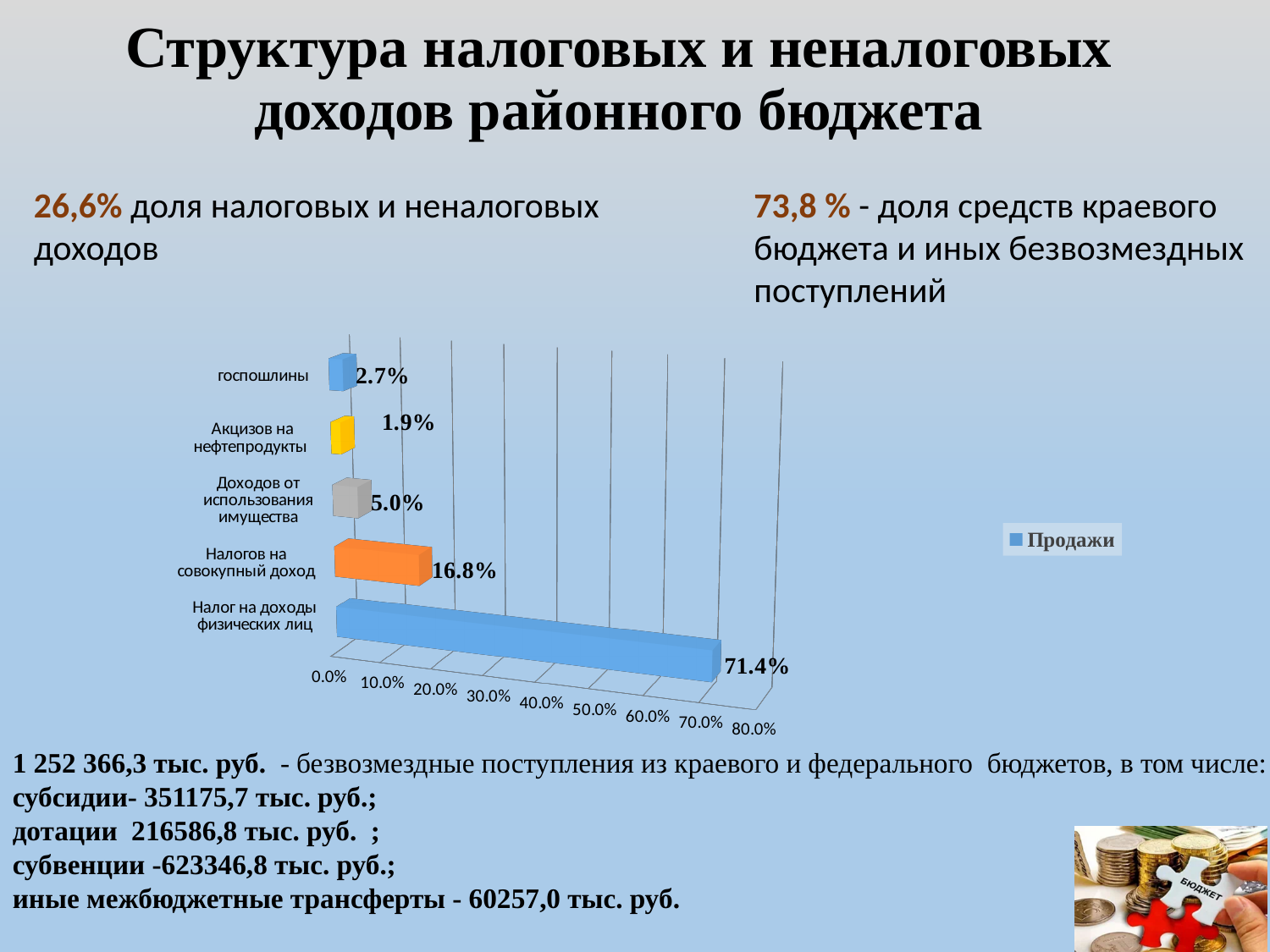
What is the difference between the values for Налог на доходы физических лиц and Налогов на совокупный доход? 54.6% How many categories are shown in the chart? 5 What kind of chart is shown on the slide? bar chart What is the value for Налог на доходы физических лиц? 71.4% Which category has the highest value? Налог на доходы физических лиц Is the value for Налог на доходы физических лиц greater or less than 70.0%? greater Which category has the lowest value? Акцизов на нефтепродукты Which is larger: the value for Доходов от использования имущества or the value for госпошлины? Доходов от использования имущества How many series does the legend list? 1 What is the value for Налогов на совокупный доход? 16.8% What is the value for госпошлины? 2.7% What is the value for Акцизов на нефтепродукты? 1.9%